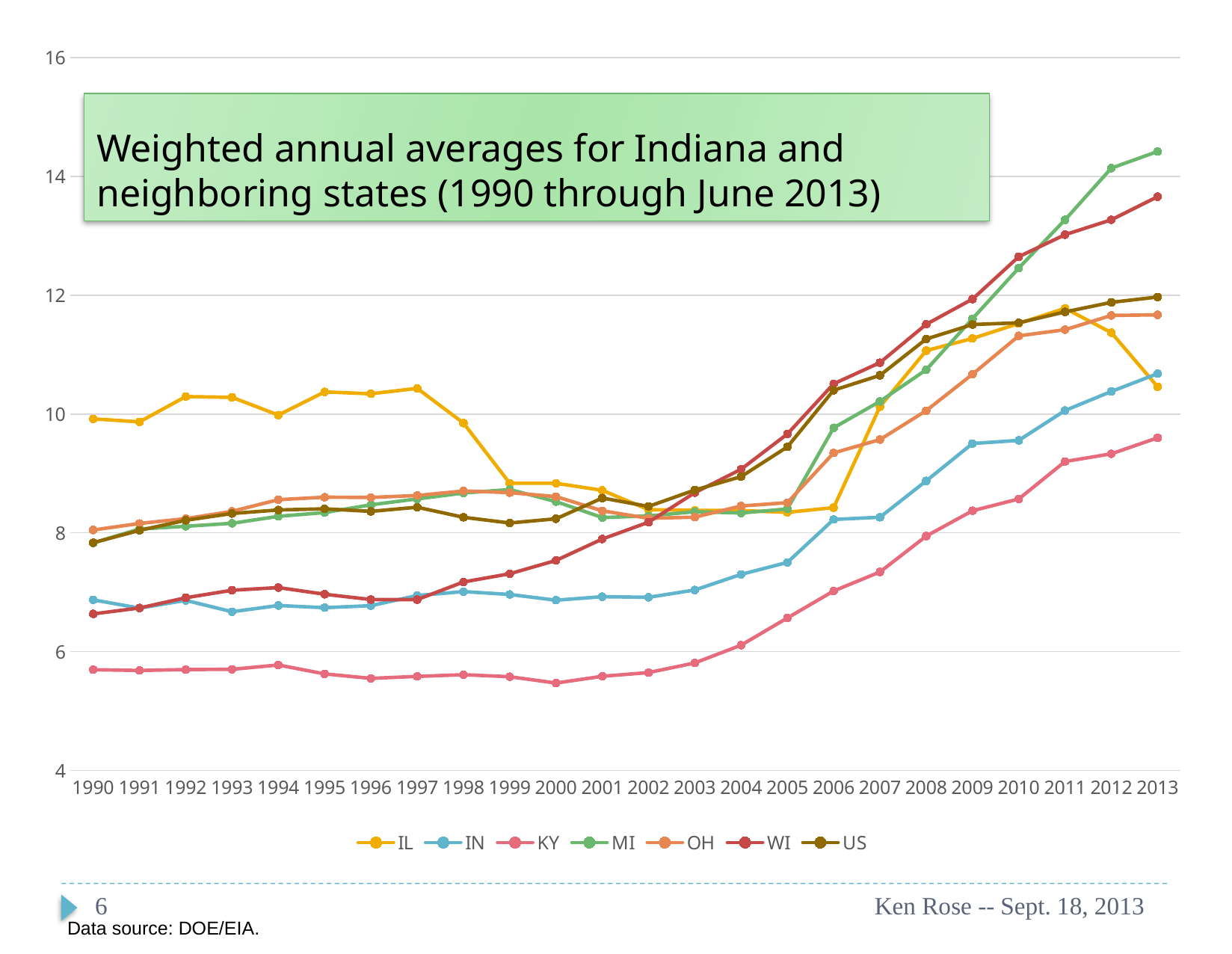
Is the value for KY in 1990 greater or less than 6? less Which series has the lowest value in 2013? KY What is the title of the chart? Weighted annual averages for Indiana and neighboring states (1990 through June 2013) Does the KY series rise or fall from 2005 to 2013? rise Which series has the highest value in 2013? MI Is the value for IL in 1995 greater or less than 10? greater How many years are plotted along the x axis? 24 How many series does the legend list? 7 What kind of chart is shown on the slide? line chart Is the value for MI in 2013 greater or less than 14? greater Which is larger in 2013, the value for MI or the value for WI? MI